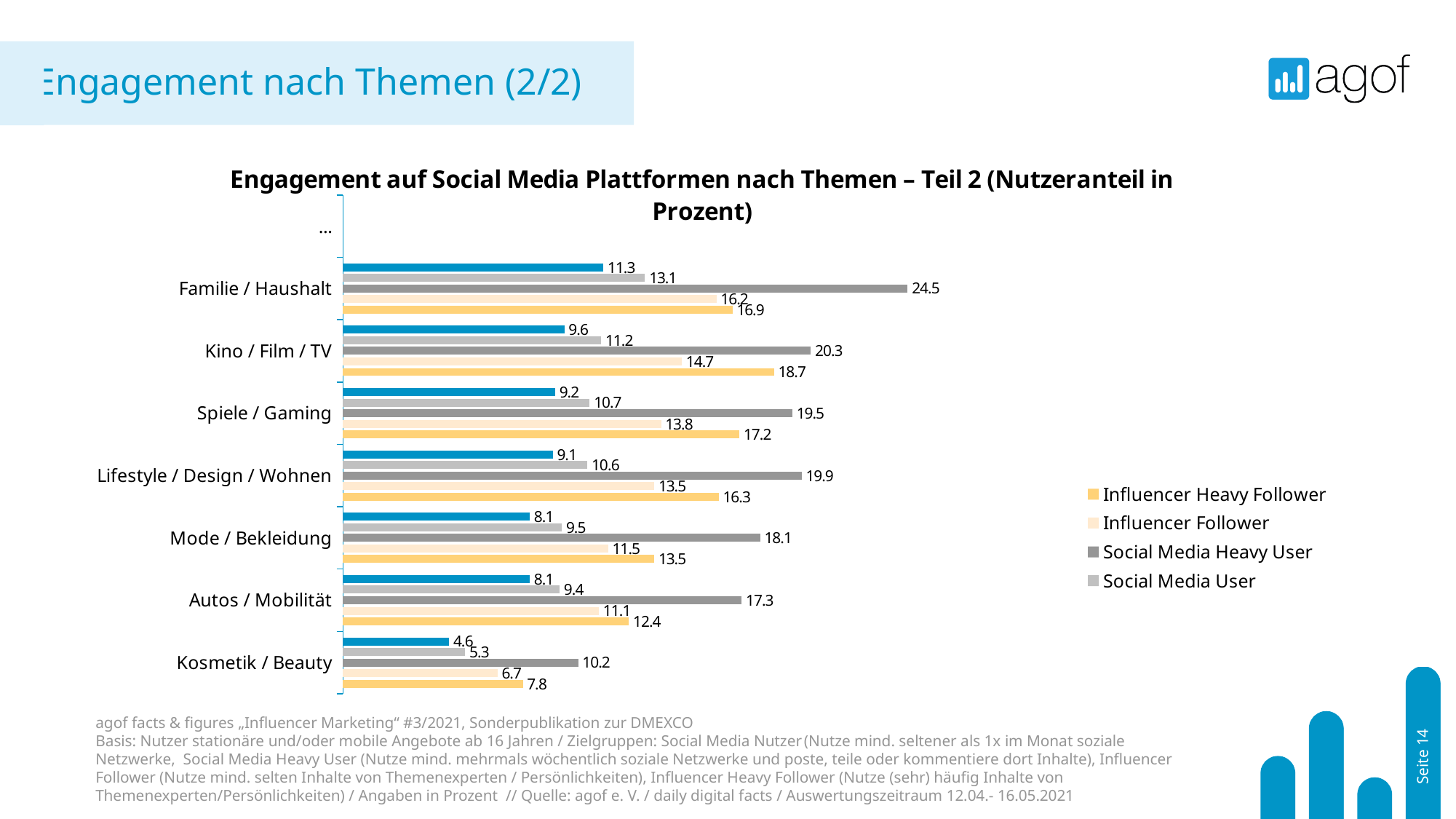
What is the value for Influencer Follower in the Kosmetik / Beauty category? 6.7 Which colour represents Influencer Heavy Follower in the legend? Yellow Which category has the lowest value for Influencer Heavy Follower? Kosmetik / Beauty What kind of chart is shown on the slide? Bar chart What is the difference between the Social Media Heavy User and Social Media User values in the Mode / Bekleidung category? 8.6 Which category has the highest value for Social Media Heavy User? Familie / Haushalt How many labelled topic categories are shown on the chart? 7 What is the value for Influencer Heavy Follower in the Kino / Film / TV category? 18.7 What is the value for Social Media User in the Spiele / Gaming category? 10.7 In the Lifestyle / Design / Wohnen category, which is larger: Influencer Heavy Follower or Influencer Follower? Influencer Heavy Follower What is the value for Social Media Heavy User in the Familie / Haushalt category? 24.5 How many series does the legend list? 4